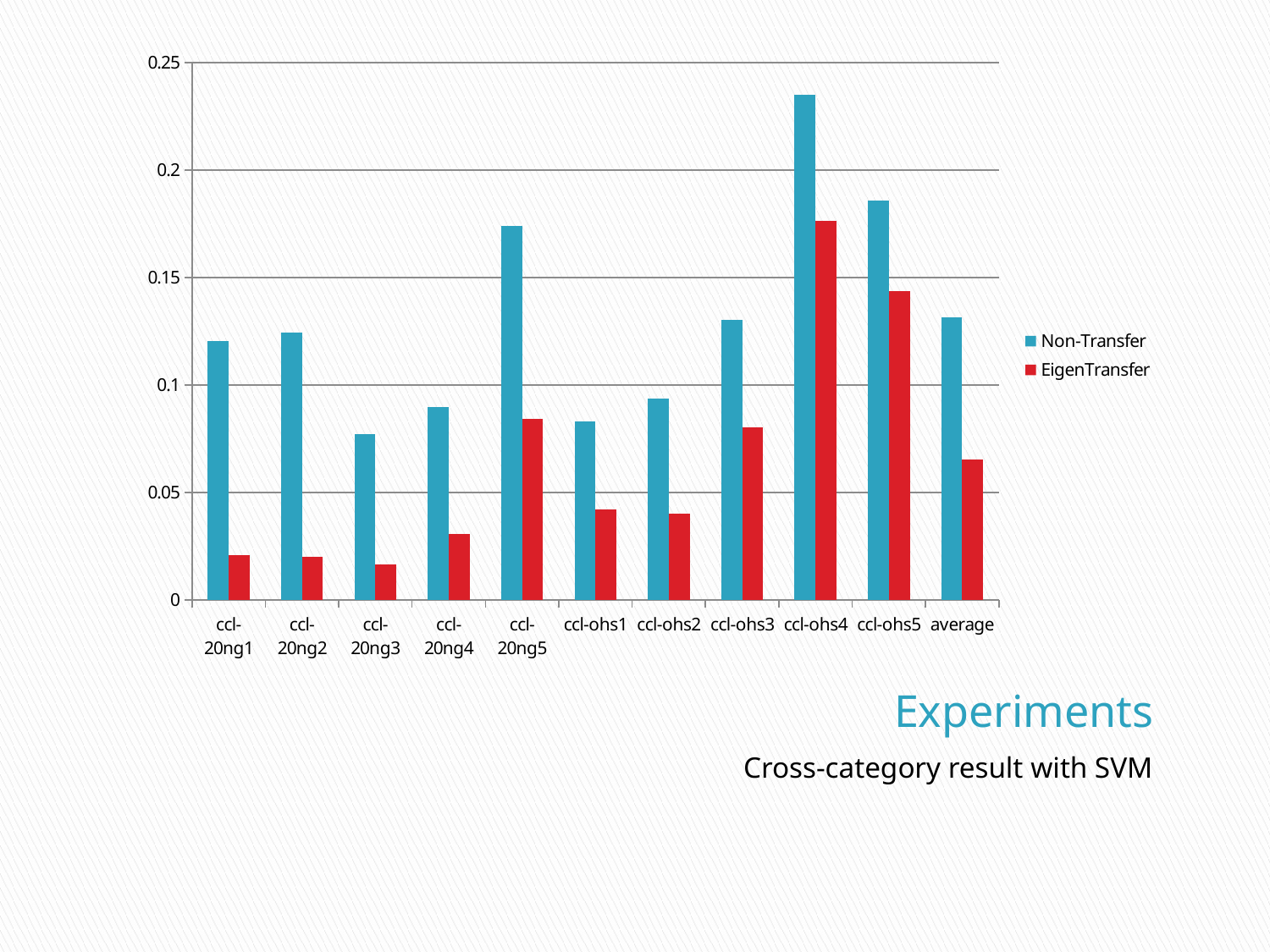
Is the Non-Transfer value for ccl-20ng5 greater or less than 0.15? greater What kind of chart is shown on the slide? bar chart How many categories are shown along the x axis? 11 For ccl-20ng1, which series has the larger value, Non-Transfer or EigenTransfer? Non-Transfer Is the EigenTransfer value for ccl-ohs4 greater or less than 0.15? greater How many series does the legend list? 2 Which colour represents the EigenTransfer series in the legend? red Which category has the highest Non-Transfer value? ccl-ohs4 Which has the larger EigenTransfer value, ccl-ohs5 or ccl-20ng5? ccl-ohs5 Is the EigenTransfer value for ccl-20ng1 greater or less than 0.05? less Which category has the highest EigenTransfer value? ccl-ohs4